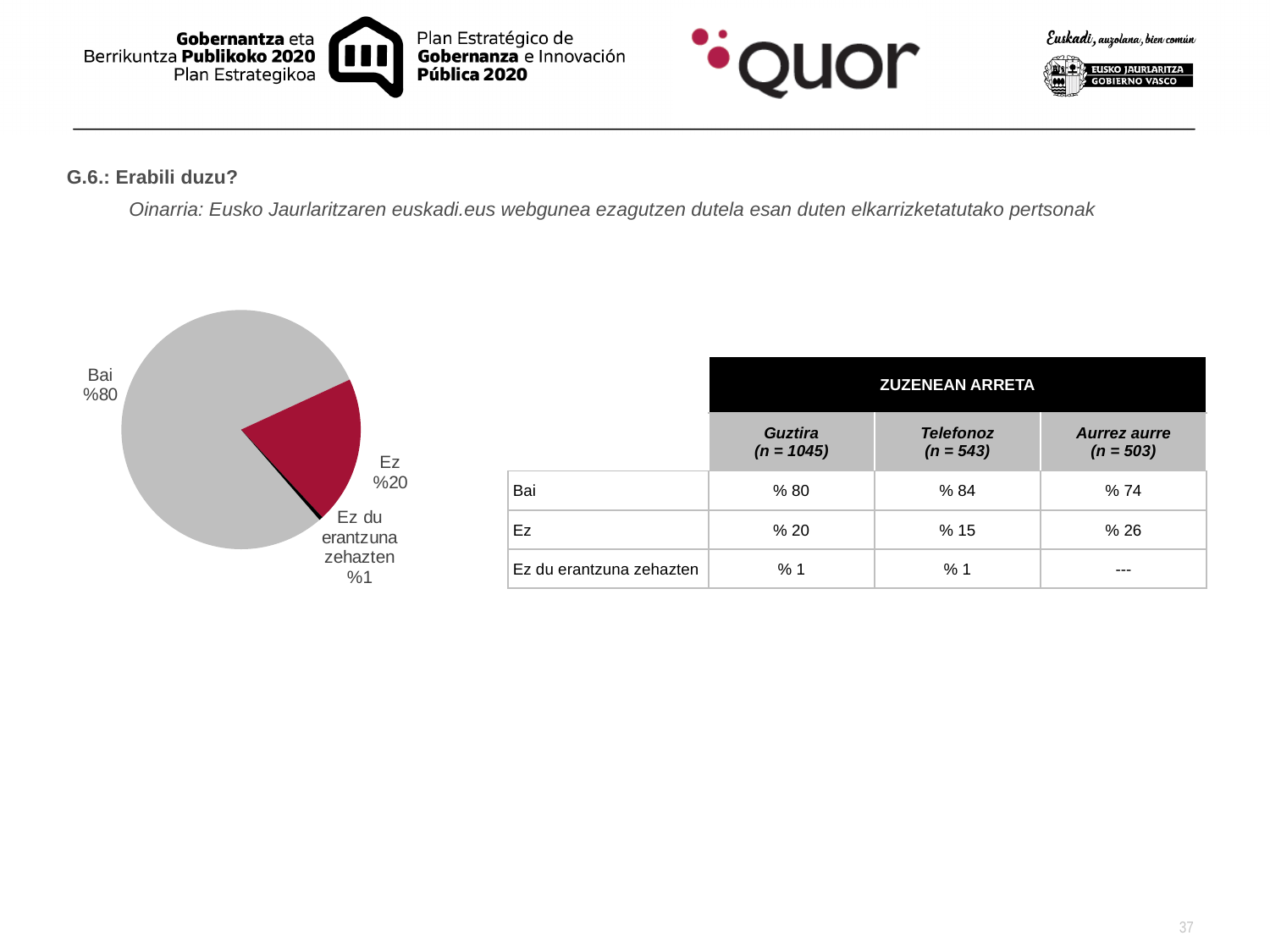
What kind of chart is shown on the slide? pie chart Which is larger in the pie chart, Ez or 'Ez du erantzuna zehazten'? Ez What is the value shown for the Ez slice of the pie chart? %20 What colour is the Ez slice in the pie chart? dark red How many slices does the pie chart have? 3 Which slice of the pie chart is the largest? Bai What colour is the Bai slice in the pie chart? grey What is the value shown for the 'Ez du erantzuna zehazten' slice of the pie chart? %1 What is the value shown for the Bai slice of the pie chart? %80 What is the difference between the Bai and Ez values in the pie chart? 60 percentage points What share of the pie does the Bai slice represent? %80 Which slice of the pie chart is the smallest? Ez du erantzuna zehazten